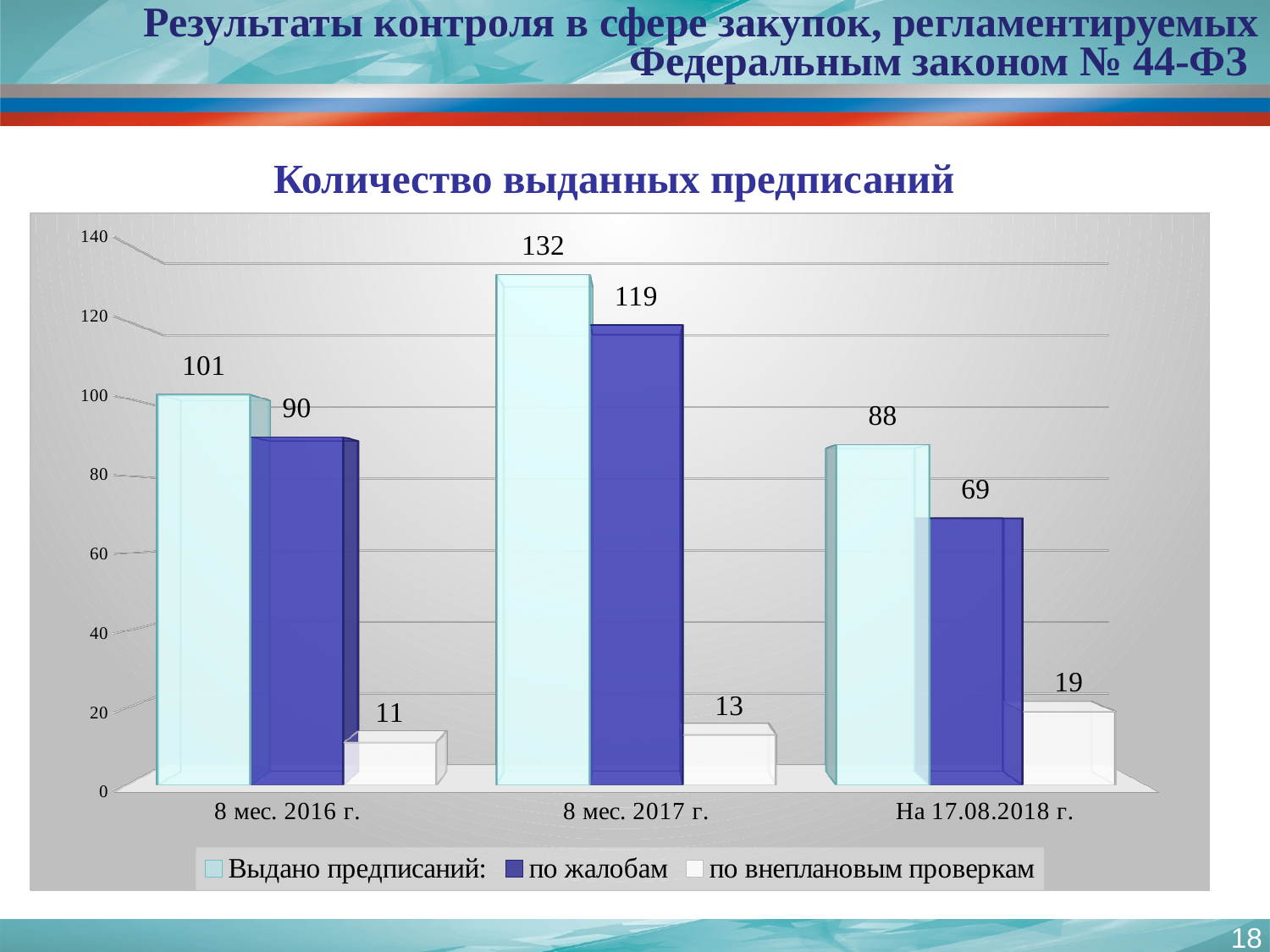
How many series does the legend list? 3 What kind of chart is shown on the slide? bar chart What is the value of "Выдано предписаний:" for "8 мес. 2017 г."? 132 Which category has the highest value for "Выдано предписаний:"? 8 мес. 2017 г. Which is larger: "по внеплановым проверкам" for "8 мес. 2017 г." or for "На 17.08.2018 г."? На 17.08.2018 г. What is the difference between "Выдано предписаний:" and "по жалобам" for "8 мес. 2016 г."? 11 Which category has the lowest value for "по жалобам"? На 17.08.2018 г. What is the value of "по внеплановым проверкам" for "8 мес. 2016 г."? 11 What is the value of "по жалобам" for "На 17.08.2018 г."? 69 How many categories are shown on the x axis? 3 Is the value of "по жалобам" for "8 мес. 2017 г." greater or less than 100? greater What is the title of the chart? Количество выданных предписаний